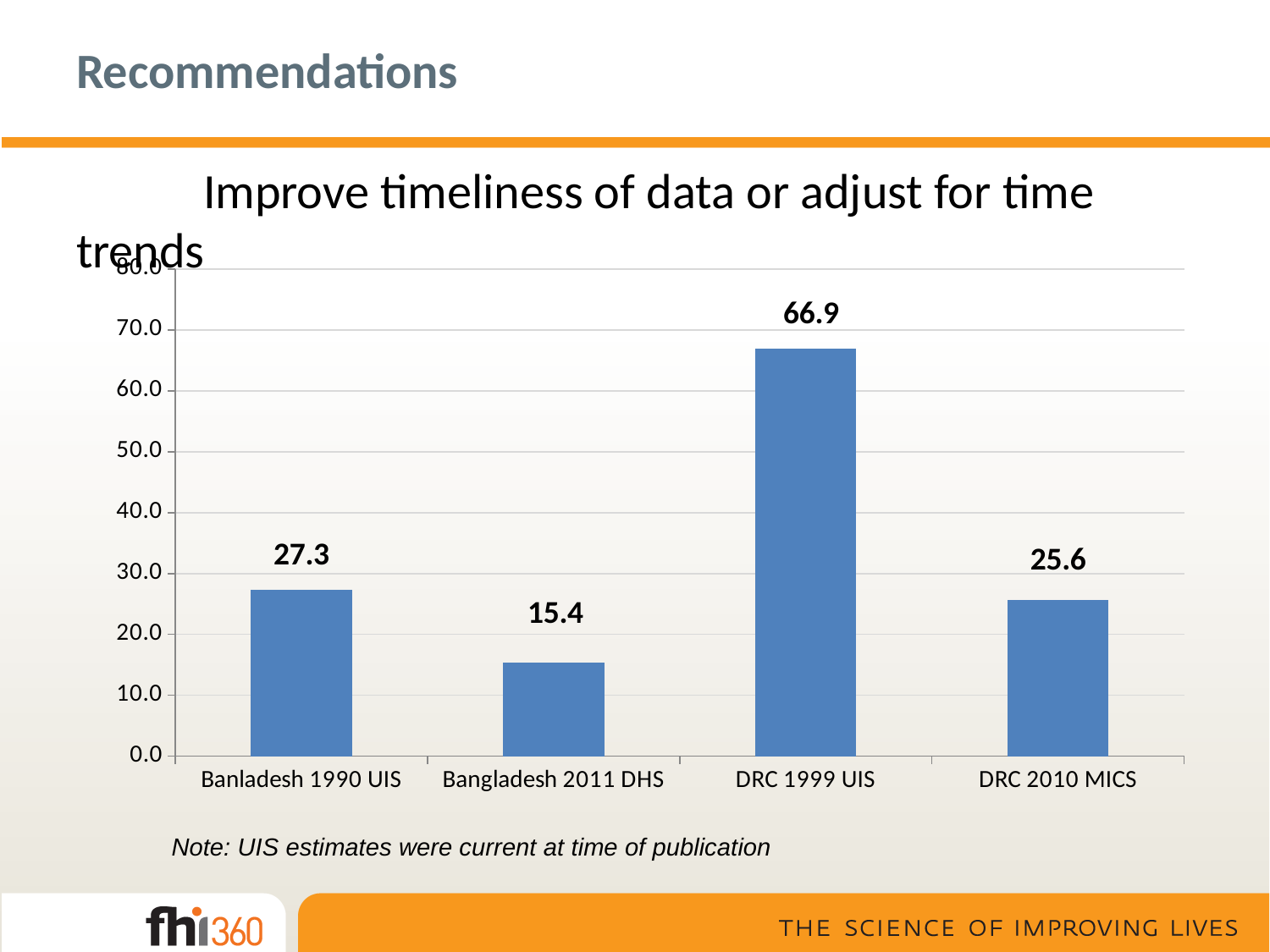
What is the difference between the values for DRC 1999 UIS and DRC 2010 MICS? 41.3 What is the value for Banladesh 1990 UIS? 27.3 How many categories are shown on the x axis? 4 What is the value for DRC 2010 MICS? 25.6 What is the value for Bangladesh 2011 DHS? 15.4 Is the value for DRC 1999 UIS greater or less than 60.0? greater Which category has the highest value? DRC 1999 UIS What is the value for DRC 1999 UIS? 66.9 What is the difference between the values for Banladesh 1990 UIS and Bangladesh 2011 DHS? 11.9 Which is larger, the value for Banladesh 1990 UIS or the value for DRC 2010 MICS? Banladesh 1990 UIS Which category has the lowest value? Bangladesh 2011 DHS What kind of chart is shown on the slide? bar chart